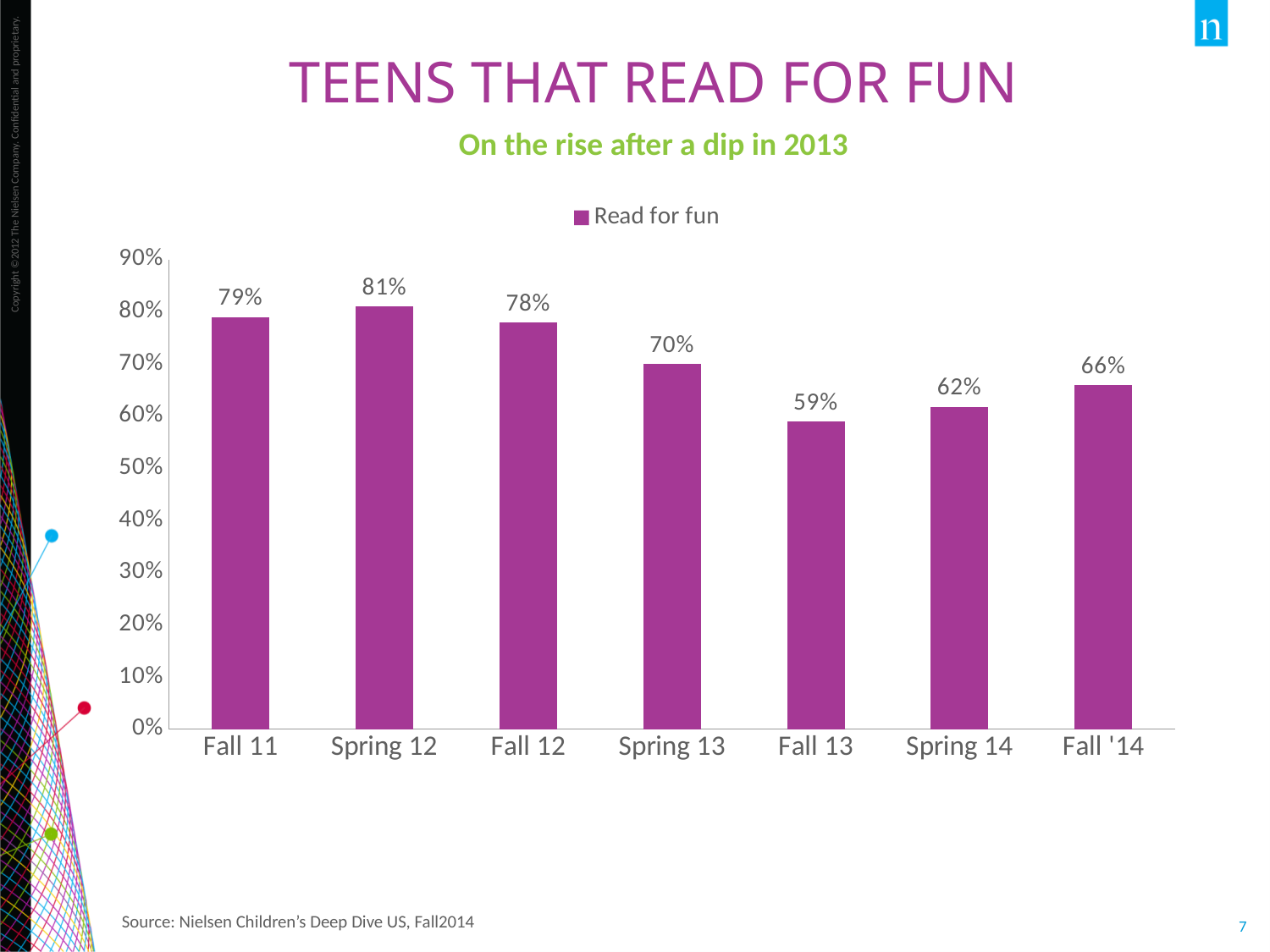
Which is larger, the value for Fall 12 or the value for Spring 14? Fall 12 What is the value for Spring 13? 70% By how many percentage points did the value rise from Fall 13 to Fall '14? 7% What kind of chart is shown on the slide? Bar chart What is the legend entry for the series shown? Read for fun How many series does the legend list? 1 What is the difference between the Spring 12 value and the Fall 13 value? 22% Which period has the highest share of teens that read for fun? Spring 12 What percentage of teens read for fun in Fall 11? 79% How many periods are shown on the x axis? 7 Which period has the lowest share of teens that read for fun? Fall 13 What is the value for Fall '14? 66%